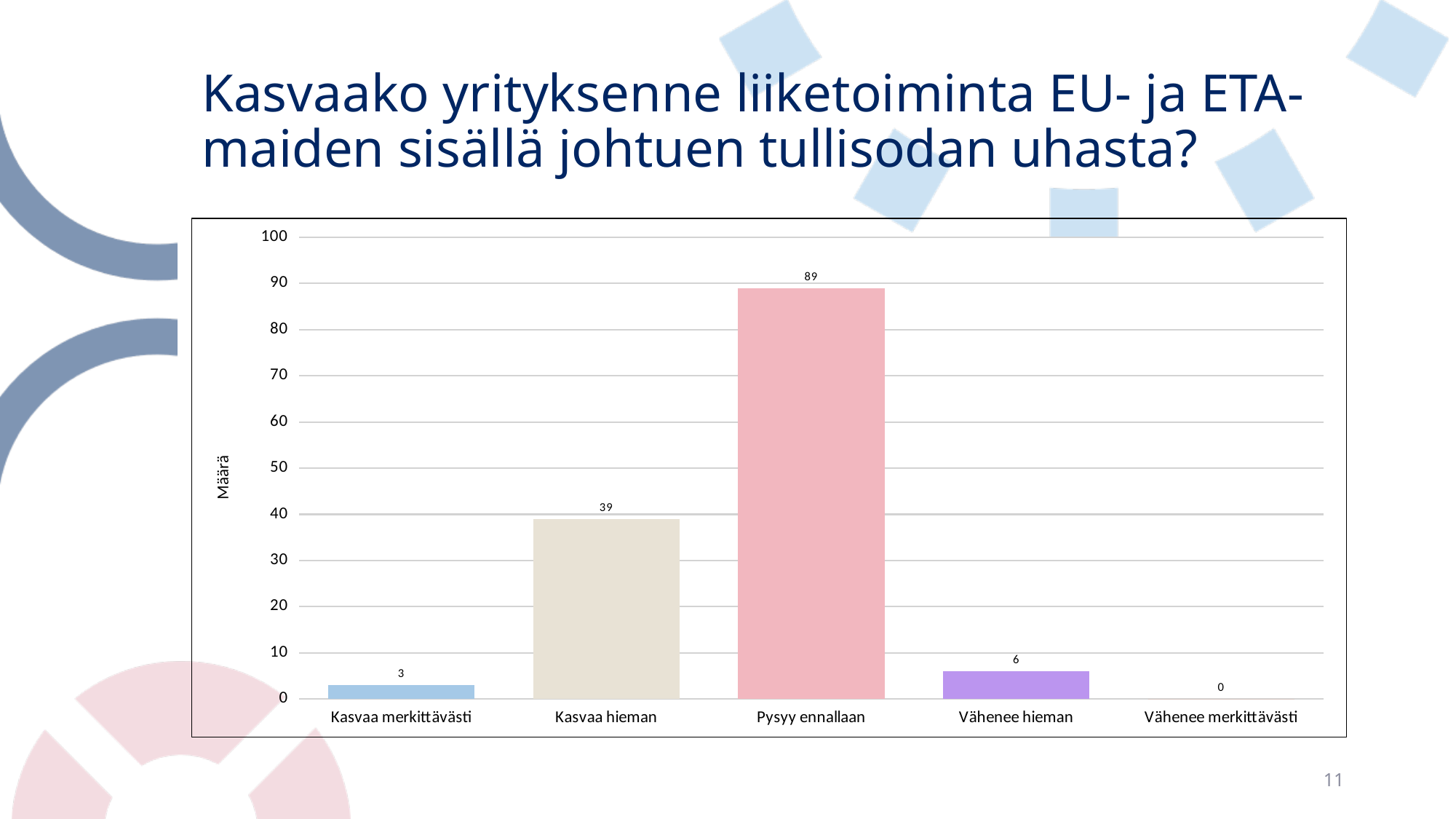
What is the value for "Kasvaa hieman"? 39 What is the value for "Vähenee merkittävästi"? 0 What is the value for "Vähenee hieman"? 6 What is the difference between the values for "Pysyy ennallaan" and "Kasvaa hieman"? 50 What kind of chart is shown on the slide? Bar chart Which category has the lowest value? Vähenee merkittävästi What is the value for "Pysyy ennallaan"? 89 What is the label of the vertical axis? Määrä What is the value for "Kasvaa merkittävästi"? 3 Which category has the highest value? Pysyy ennallaan Which is larger, the value for "Vähenee hieman" or the value for "Kasvaa merkittävästi"? Vähenee hieman How many categories are shown on the x axis? 5